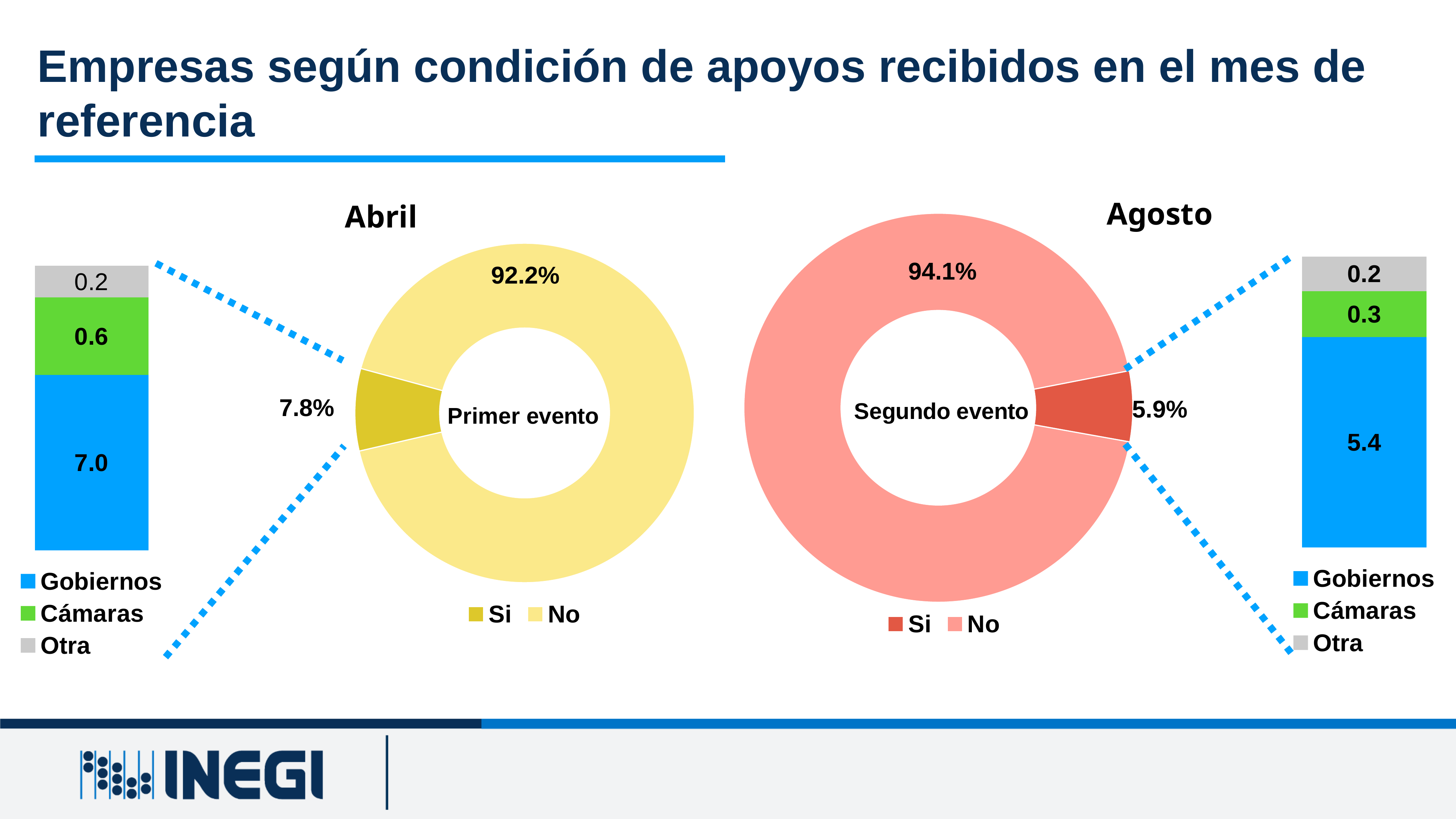
What is the difference between the Gobiernos value in the Abril stacked bar and the Gobiernos value in the Agosto stacked bar? 1.6 In the Abril doughnut chart, what percentage is shown for "No"? 92.2% What is the total of the stacked bar on the left (Abril)? 7.8 In the Abril doughnut chart, what percentage is shown for "Si"? 7.8% In the Agosto doughnut chart, what percentage is shown for "No"? 94.1% How many entries does the legend of the Agosto doughnut chart list? 2 In the stacked bar on the right (Agosto), which category has the smallest value? Otra In the Agosto doughnut chart, what percentage is shown for "Si"? 5.9% Which is larger: the "Si" share in the Abril doughnut chart or the "Si" share in the Agosto doughnut chart? Abril In the stacked bar on the left (Abril), what is the value for Gobiernos? 7.0 In the stacked bar on the left (Abril), which category has the largest value? Gobiernos In the stacked bar on the right (Agosto), what is the value for Cámaras? 0.3